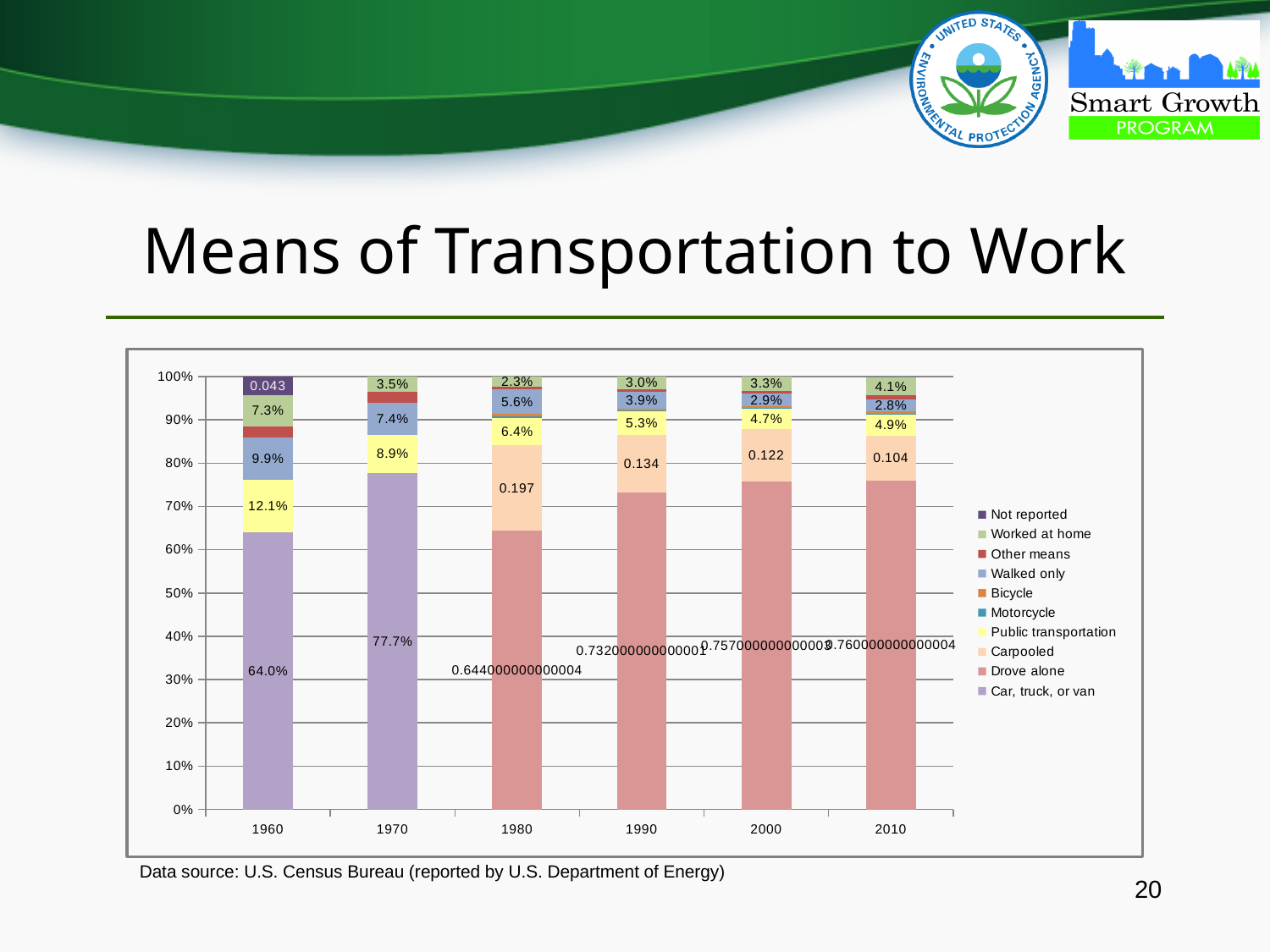
Does the Worked at home share rise or fall from 1980 to 2010? Rise What is the difference between the Public transportation values for 1960 and 1970? 3.2% In which year is the Public transportation share highest? 1960 What is the value for Car, truck, or van in 1960? 64.0% How many years are shown on the x axis? 6 What is the value for Worked at home in 2010? 4.1% What is the value for Public transportation in 1970? 8.9% What is the value for Walked only in 1980? 5.6% How many series does the legend list? 10 In which year is the Walked only share lowest? 2010 What is the value for Carpooled in 1990? 0.134 What type of chart is shown on the slide? Stacked bar chart